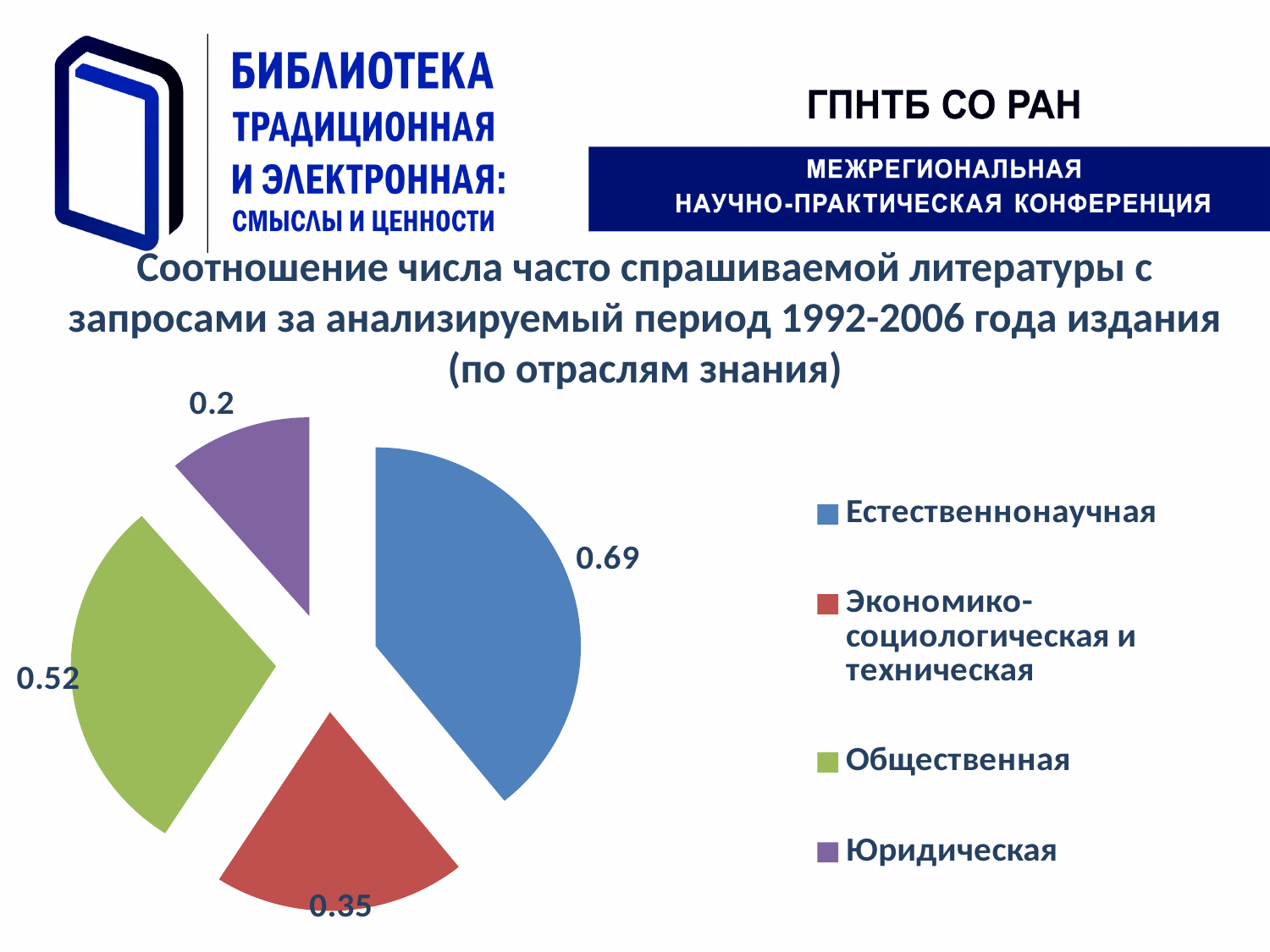
How many categories does the pie chart have? 4 What is the value for Естественнонаучная? 0.69 What is the difference between the values for Общественная and Экономико-социологическая и техническая? 0.17 What is the value for Экономико-социологическая и техническая? 0.35 Which category has the smallest slice? Юридическая What colour is the slice for Общественная? green Which category has the largest slice? Естественнонаучная Which is larger, the value for Общественная or the value for Экономико-социологическая и техническая? Общественная What is the value for Общественная? 0.52 What is the value for Юридическая? 0.2 What kind of chart is shown on the slide? pie chart What is the difference between the values for Естественнонаучная and Юридическая? 0.49